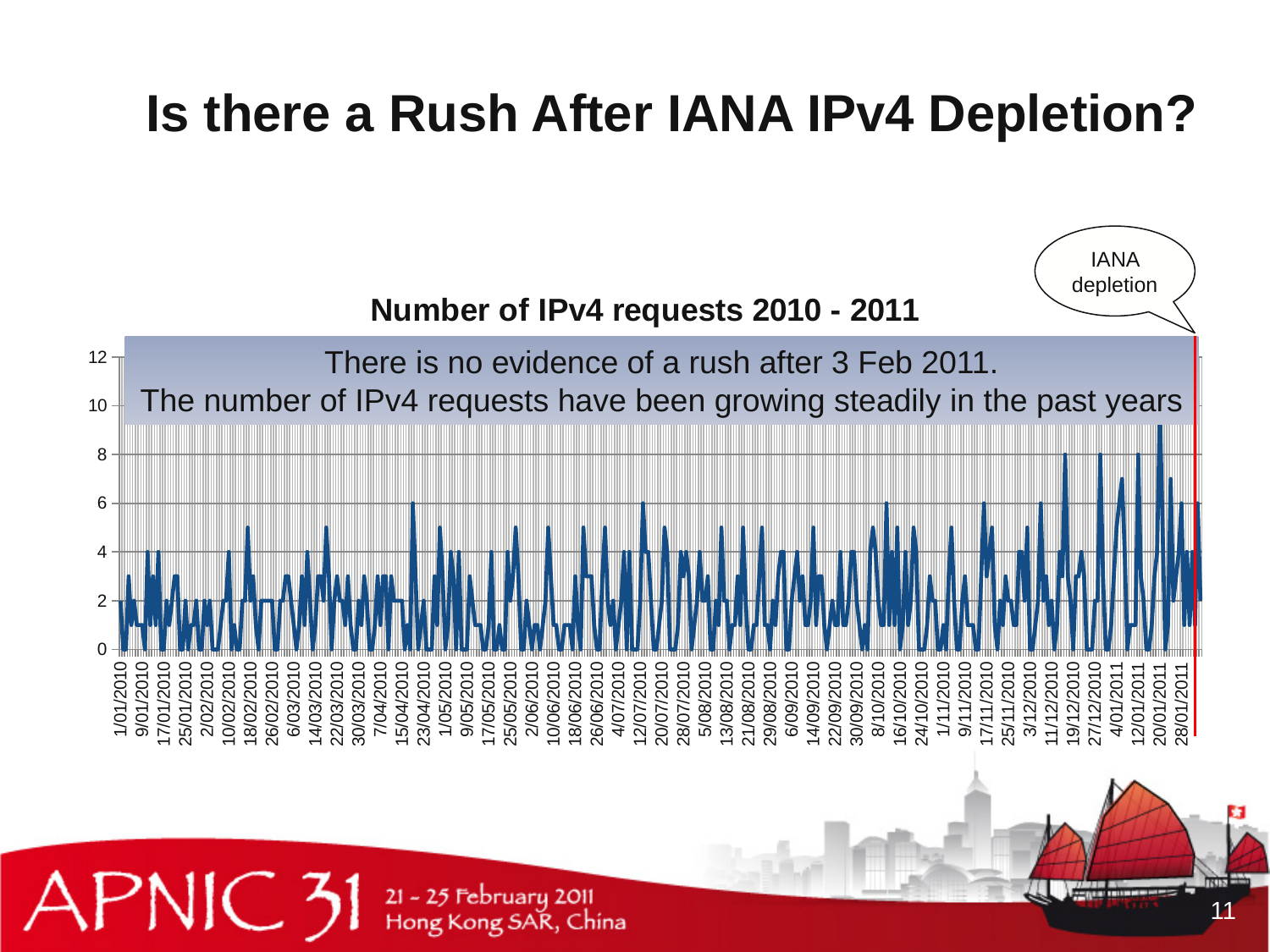
According to the slide, has the number of IPv4 requests been growing or declining over the period shown? growing Is the highest peak on the chart greater or less than 8? greater What kind of chart is shown on the slide? line chart What event does the red vertical line at the right edge of the chart mark? IANA depletion Is the highest peak in January 2011 greater or less than 6? greater What is the lowest value the line reaches on the chart? 0 What is the title of the chart? Number of IPv4 requests 2010 - 2011